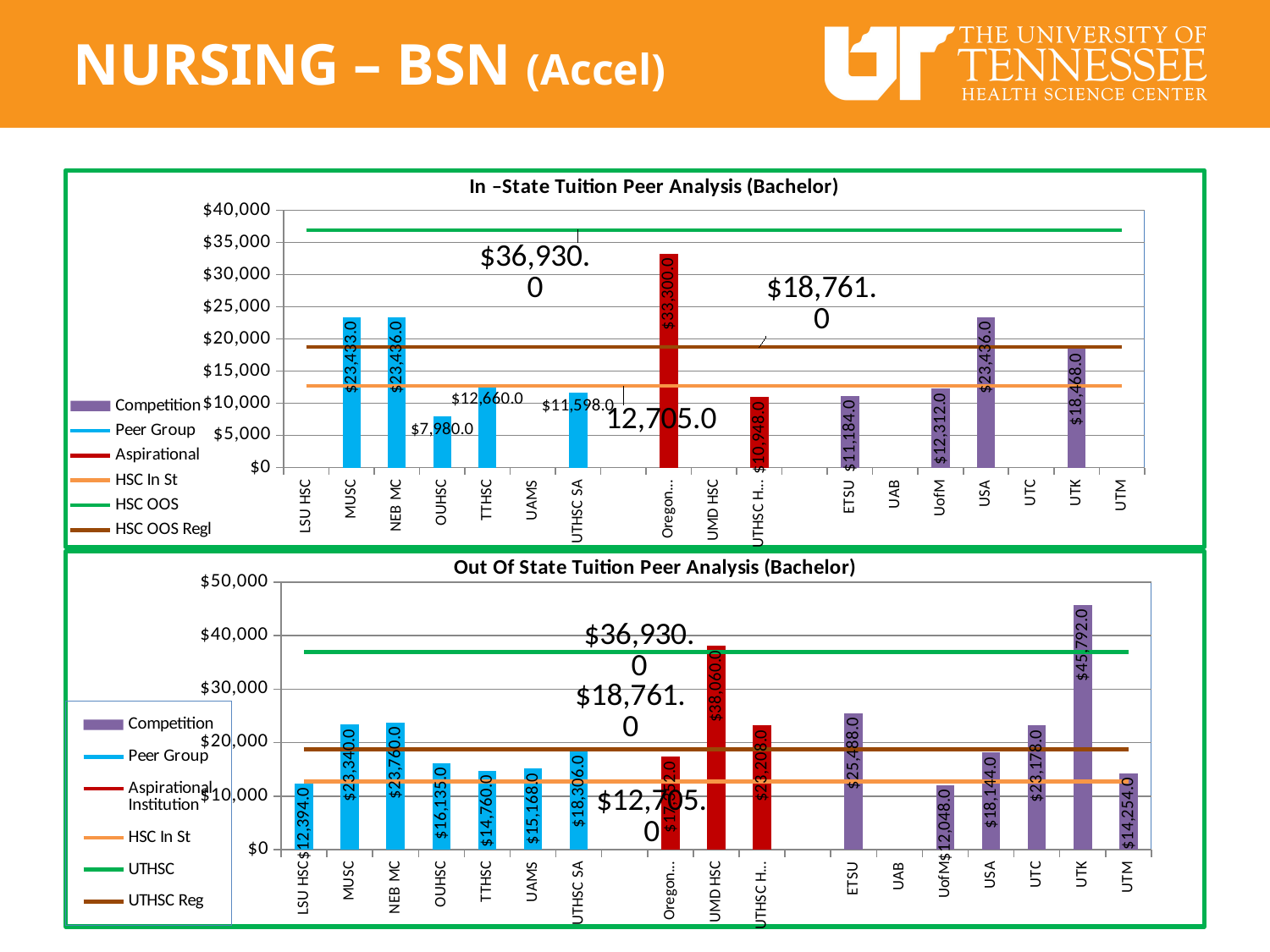
In the Out Of State Tuition Peer Analysis chart, what is the value for UTK? $45,792.0 In the In-State Tuition Peer Analysis chart, which institution has the highest bar? Oregon In the In-State Tuition Peer Analysis chart, is the value for MUSC greater or less than $20,000? greater In the Out Of State Tuition Peer Analysis chart, what is the value for ETSU? $25,488.0 In the Out Of State Tuition Peer Analysis chart, what is the difference between the UMD HSC and UTHSC SA values? $19,754.0 In the In-State Tuition Peer Analysis chart, how many entries does the legend list? 6 In the Out Of State Tuition Peer Analysis chart, which is larger, the value for NEB MC or the value for MUSC? NEB MC What kind of chart is the Out Of State Tuition Peer Analysis chart? Bar chart In the Out Of State Tuition Peer Analysis chart, which institution has the lowest bar? UofM In the In-State Tuition Peer Analysis chart, what is the value for UTK? $18,468.0 In the In-State Tuition Peer Analysis chart, what is the difference between the TTHSC and UTHSC SA values? $1,062.0 In the In-State Tuition Peer Analysis chart, what is the value for OUHSC? $7,980.0